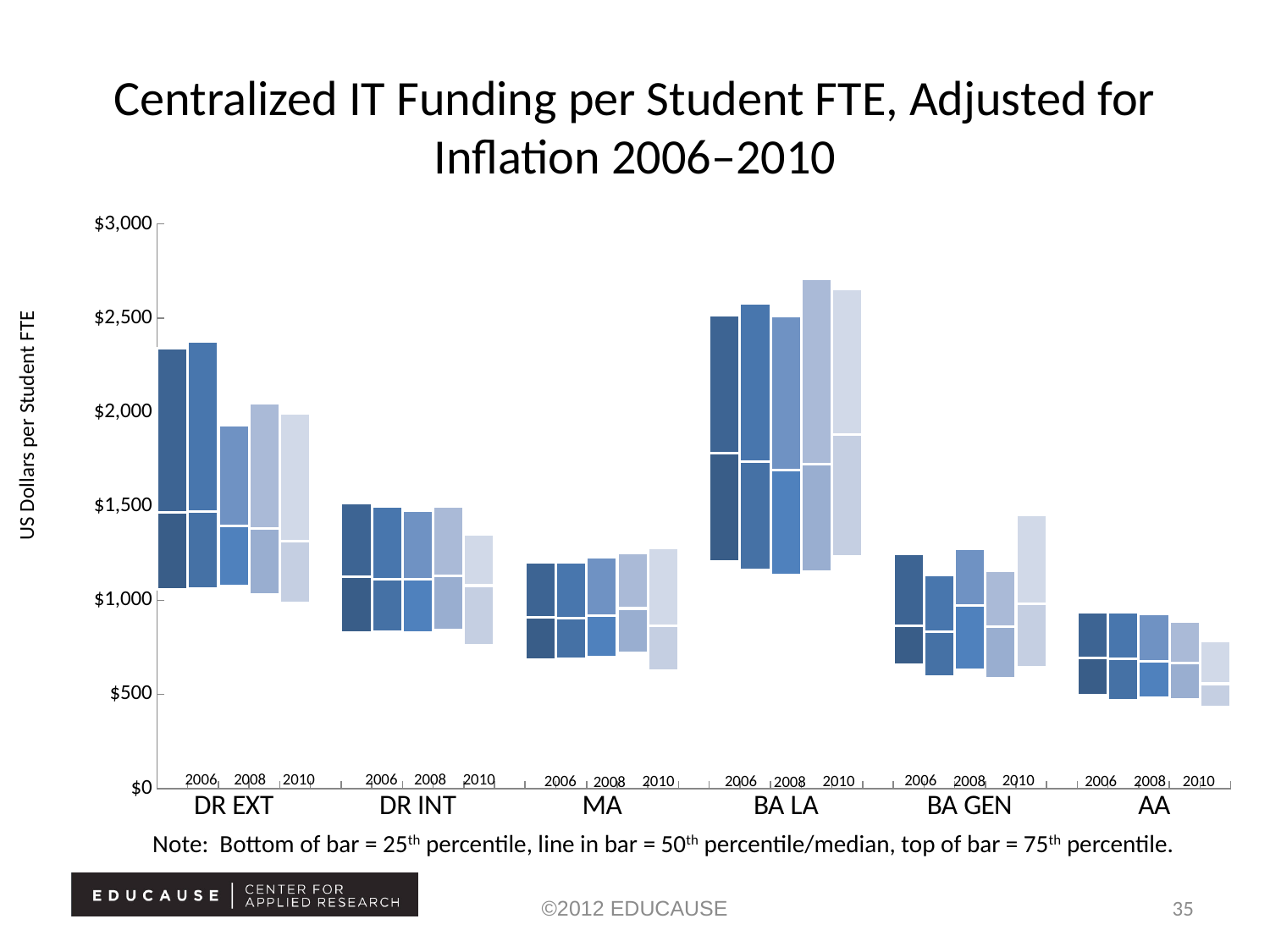
Is the top of the 2010 bar for AA greater or less than $1,000? less According to the note, what does the line inside each bar represent? 50th percentile/median Which institution category has the lowest 25th percentile (bottom of bar) values? AA Is the bottom of the 2006 bar for MA greater or less than $1,000? less Is the top of the 2006 bar for DR EXT greater or less than $2,000? greater What kind of chart is shown on the slide? bar chart How many bars are plotted for each institution category? 5 What is the label on the vertical axis? US Dollars per Student FTE Which institution category has the highest 75th percentile (top of bar) values? BA LA How many institution categories are shown along the x axis? 6 Does the median (line in bar) for AA rise or fall from 2006 to 2010? fall